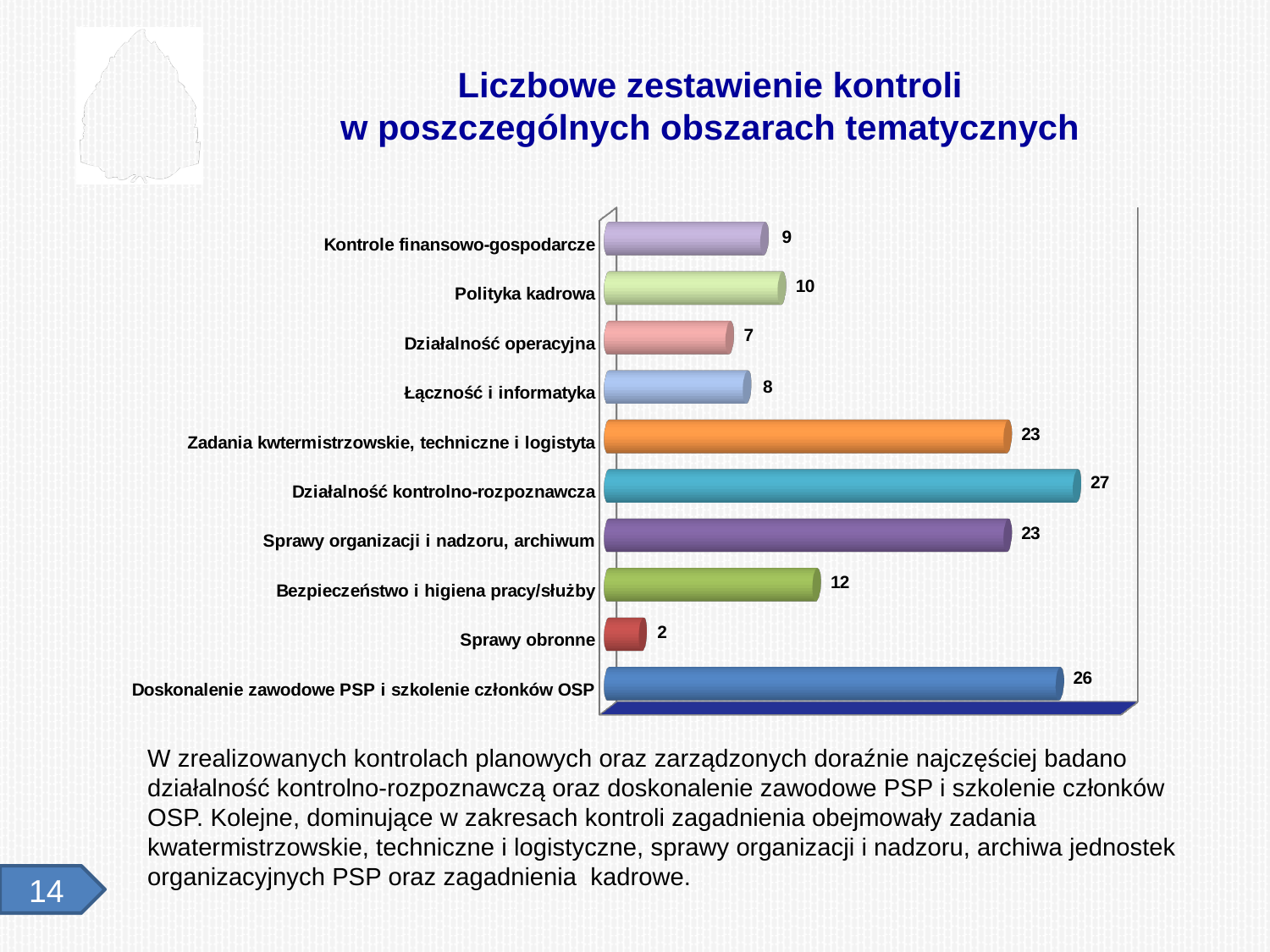
What is the value for Polityka kadrowa? 10 What is the difference between the values for Działalność kontrolno-rozpoznawcza and Doskonalenie zawodowe PSP i szkolenie członków OSP? 1 Which two categories share the value 23? Zadania kwtermistrzowskie, techniczne i logistyta; Sprawy organizacji i nadzoru, archiwum How many categories are shown in the chart? 10 What is the title of the slide? Liczbowe zestawienie kontroli w poszczególnych obszarach tematycznych Which category has the highest value? Działalność kontrolno-rozpoznawcza Which category has the lowest value? Sprawy obronne What is the difference between the values for Bezpieczeństwo i higiena pracy/służby and Działalność operacyjna? 5 What kind of chart is shown on the slide? Bar chart What is the value for Sprawy obronne? 2 What is the value for Działalność kontrolno-rozpoznawcza? 27 Which is larger: the value for Kontrole finansowo-gospodarcze or the value for Łączność i informatyka? Kontrole finansowo-gospodarcze